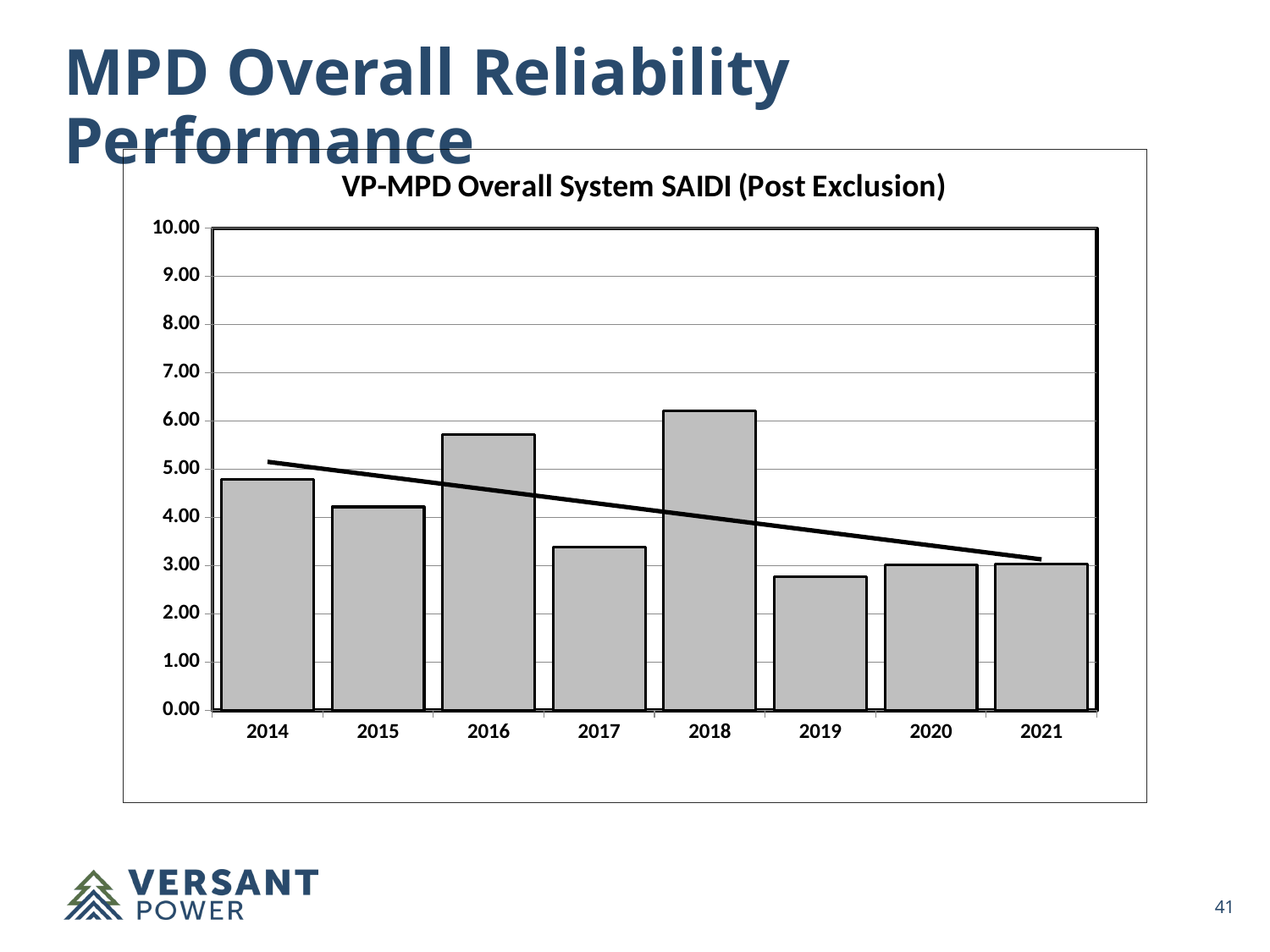
Which year has the larger value, 2016 or 2014? 2016 Is the value for 2017 greater or less than 4.00? less Is the value for 2018 greater or less than 5.00? greater According to the trend line, do the SAIDI values generally rise or fall from 2014 to 2021? Fall What is the title of the chart? VP-MPD Overall System SAIDI (Post Exclusion) Is the value for 2016 greater or less than 5.00? greater What type of chart is shown on the slide? Bar chart Which year has the lowest SAIDI value? 2019 Which year has the highest SAIDI value? 2018 Which year has the larger value, 2015 or 2017? 2015 How many years are shown on the x axis of the chart? 8